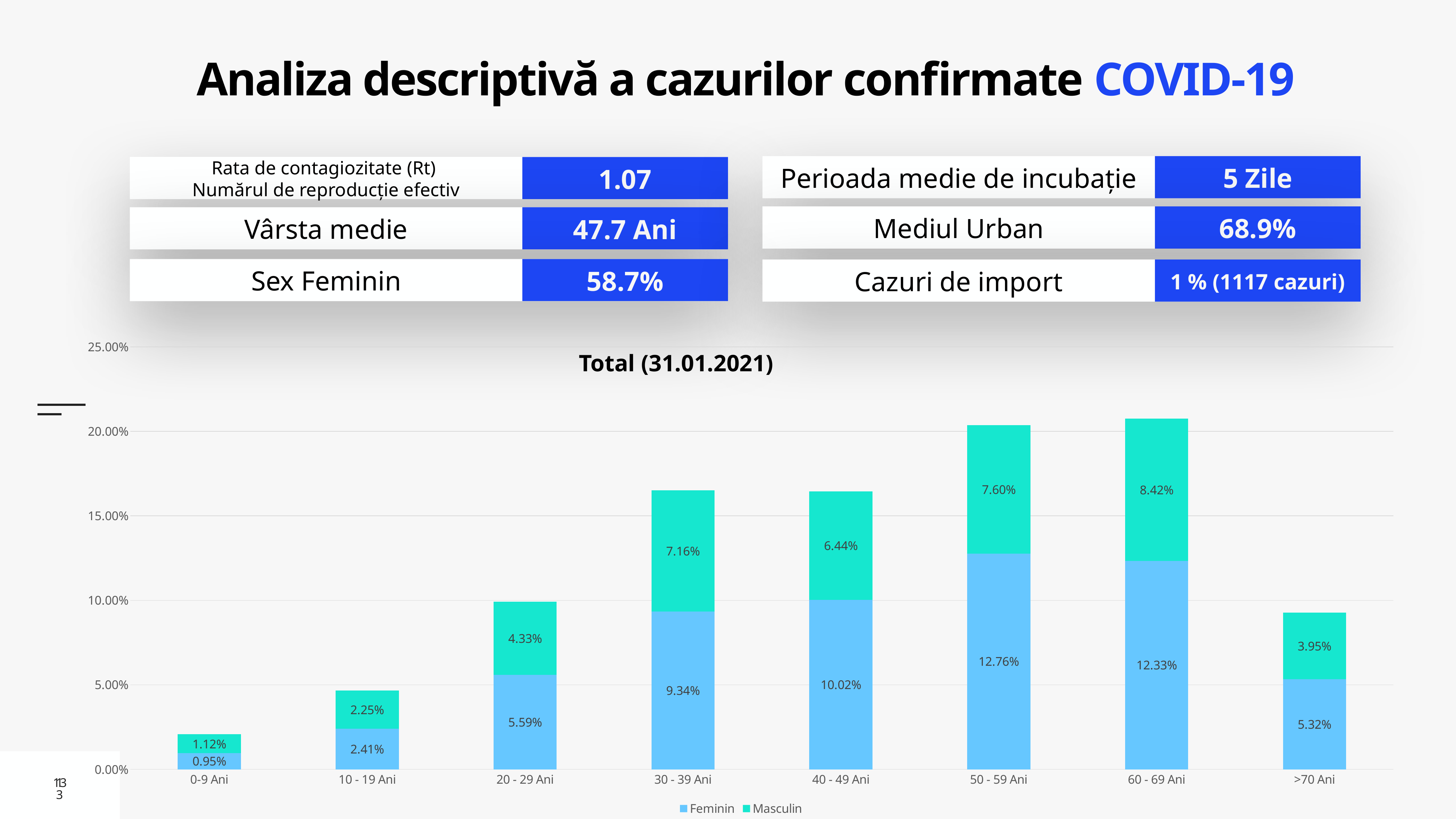
How many age groups are shown on the x axis? 8 How many series does the legend list? 2 Which age group has the highest Masculin value? 60 - 69 Ani What type of chart is shown on the slide? stacked bar chart Is the total value for the 30 - 39 Ani bar greater or less than 15.00%? greater What is the Feminin value for the >70 Ani age group? 5.32% What is the Masculin value for the 30 - 39 Ani age group? 7.16% Which age group has the lowest Feminin value? 0-9 Ani Which is larger, the Feminin value for 40 - 49 Ani or the Feminin value for 30 - 39 Ani? 40 - 49 Ani What is the Feminin value for the 50 - 59 Ani age group? 12.76% What is the total of the stacked bar for the 20 - 29 Ani age group? 9.92% What is the difference between the Masculin values for 60 - 69 Ani and 50 - 59 Ani? 0.82%